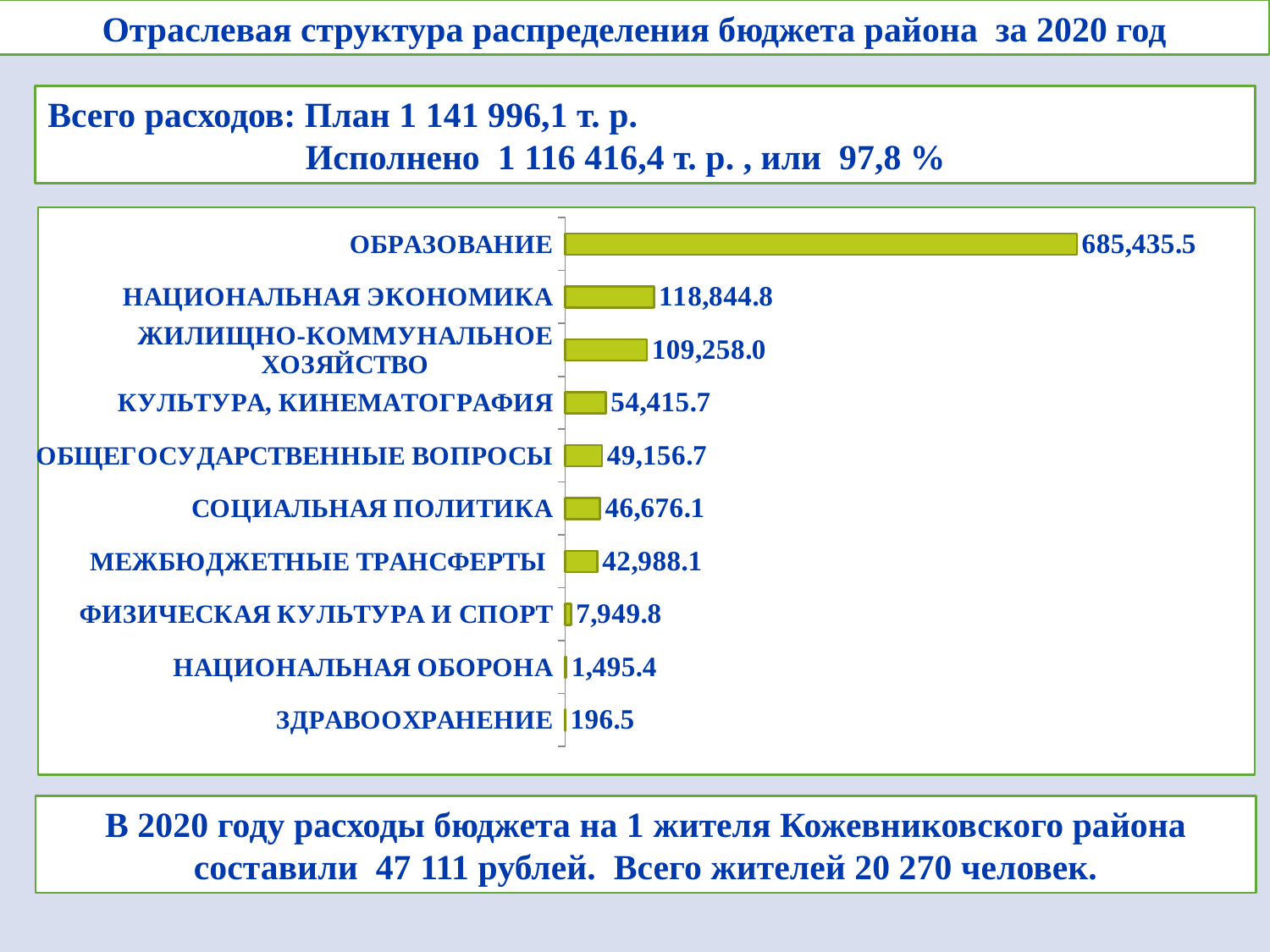
What is the value for ОБРАЗОВАНИЕ? 685,435.5 How many categories are shown in the chart? 10 Which category has the highest value? ОБРАЗОВАНИЕ What is the value for МЕЖБЮДЖЕТНЫЕ ТРАНСФЕРТЫ? 42,988.1 Do the values increase or decrease going from the top category to the bottom category? Decrease What is the value for ЖИЛИЩНО-КОММУНАЛЬНОЕ ХОЗЯЙСТВО? 109,258.0 What is the difference between НАЦИОНАЛЬНАЯ ЭКОНОМИКА and ЖИЛИЩНО-КОММУНАЛЬНОЕ ХОЗЯЙСТВО? 9,586.8 Which is larger, СОЦИАЛЬНАЯ ПОЛИТИКА or ФИЗИЧЕСКАЯ КУЛЬТУРА И СПОРТ? СОЦИАЛЬНАЯ ПОЛИТИКА What is the value for ЗДРАВООХРАНЕНИЕ? 196.5 What kind of chart is shown on the slide? Bar chart Which category has the lowest value? ЗДРАВООХРАНЕНИЕ What is the difference between КУЛЬТУРА, КИНЕМАТОГРАФИЯ and ОБЩЕГОСУДАРСТВЕННЫЕ ВОПРОСЫ? 5,259.0